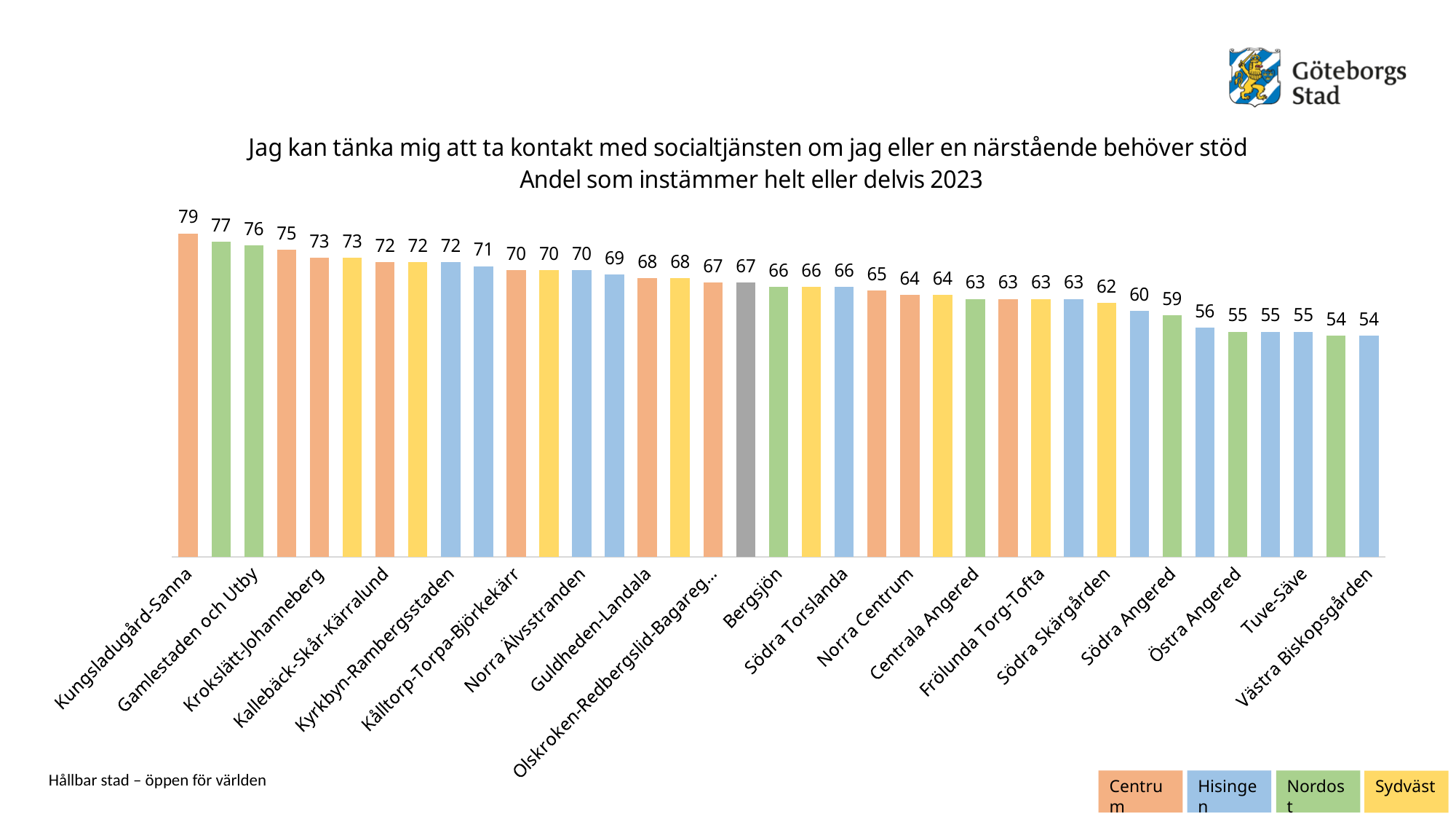
What is the value for Södra Angered? 59 What is the lowest value shown in the chart? 54 Which category has the highest value? Kungsladugård-Sanna What is the difference between the values for Kungsladugård-Sanna and Västra Biskopsgården? 25 Which is larger, the value for Bergsjön or the value for Södra Angered? Bergsjön Do the values rise or fall from left to right along the x axis? Fall What is the value for Norra Centrum? 64 What is the value for Bergsjön? 66 What kind of chart is shown on the slide? Bar chart What is the value for Västra Biskopsgården? 54 What is the value for Kungsladugård-Sanna? 79 How many series does the legend list? 4